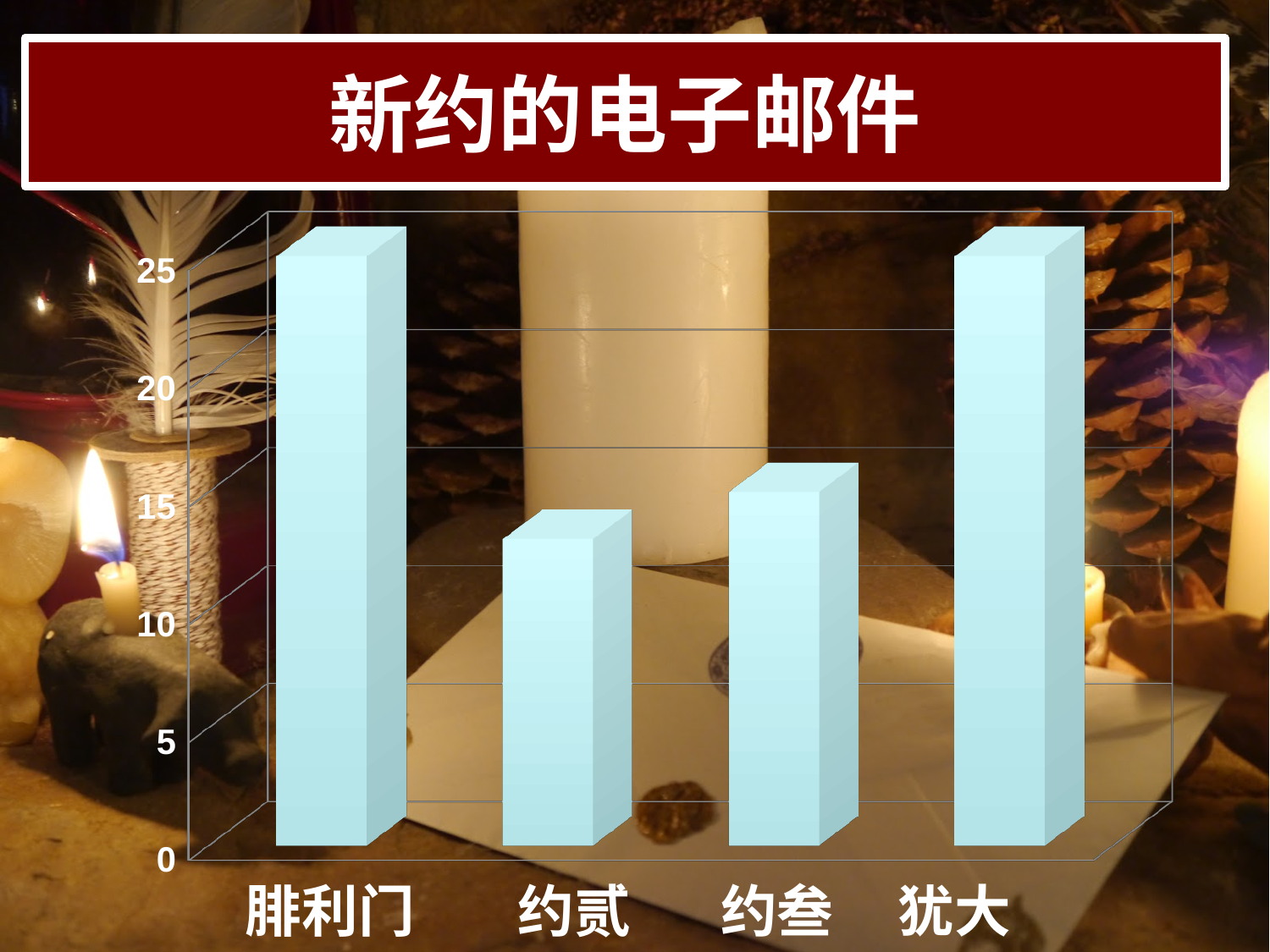
Which is larger, the value for 腓利门 or the value for 约叁? 腓利门 How many categories are shown on the x axis of the chart? 4 Is the value for 犹大 greater or less than 20? greater Is the value for 腓利门 greater or less than 20? greater Is the value for 约叁 greater or less than 20? less Which category has the lowest bar in the chart? 约贰 Which is larger, the value for 约叁 or the value for 约贰? 约叁 What is the title of the chart? 新约的电子邮件 What kind of chart is shown on the slide? bar chart What is the highest tick value shown on the vertical axis of the chart? 25